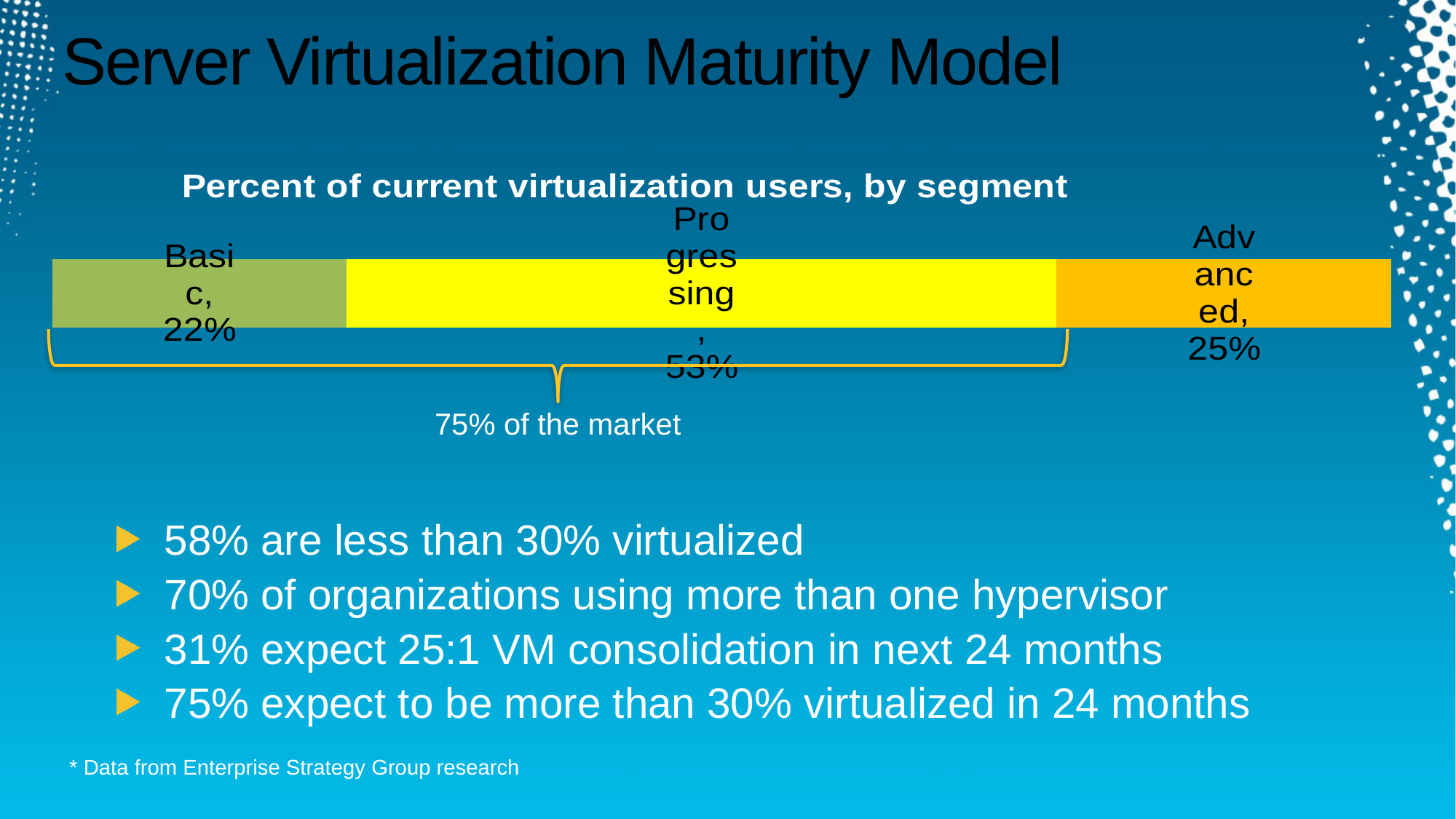
What is the difference between the Advanced and Basic segment percentages? 3% What is the difference between the Progressing and Advanced segment percentages? 28% What kind of chart is used to show the percent of current virtualization users by segment? Stacked bar chart What percentage of current virtualization users are in the Progressing segment? 53% What percentage of current virtualization users are in the Advanced segment? 25% Which segment has the largest share of current virtualization users? Progressing How many segments are shown in the bar? 3 What is the title of the chart? Percent of current virtualization users, by segment What percentage of current virtualization users are in the Basic segment? 22% Which segment is larger, Basic or Advanced? Advanced What is the combined percentage of the Basic and Progressing segments? 75% Which segment has the smallest share of current virtualization users? Basic